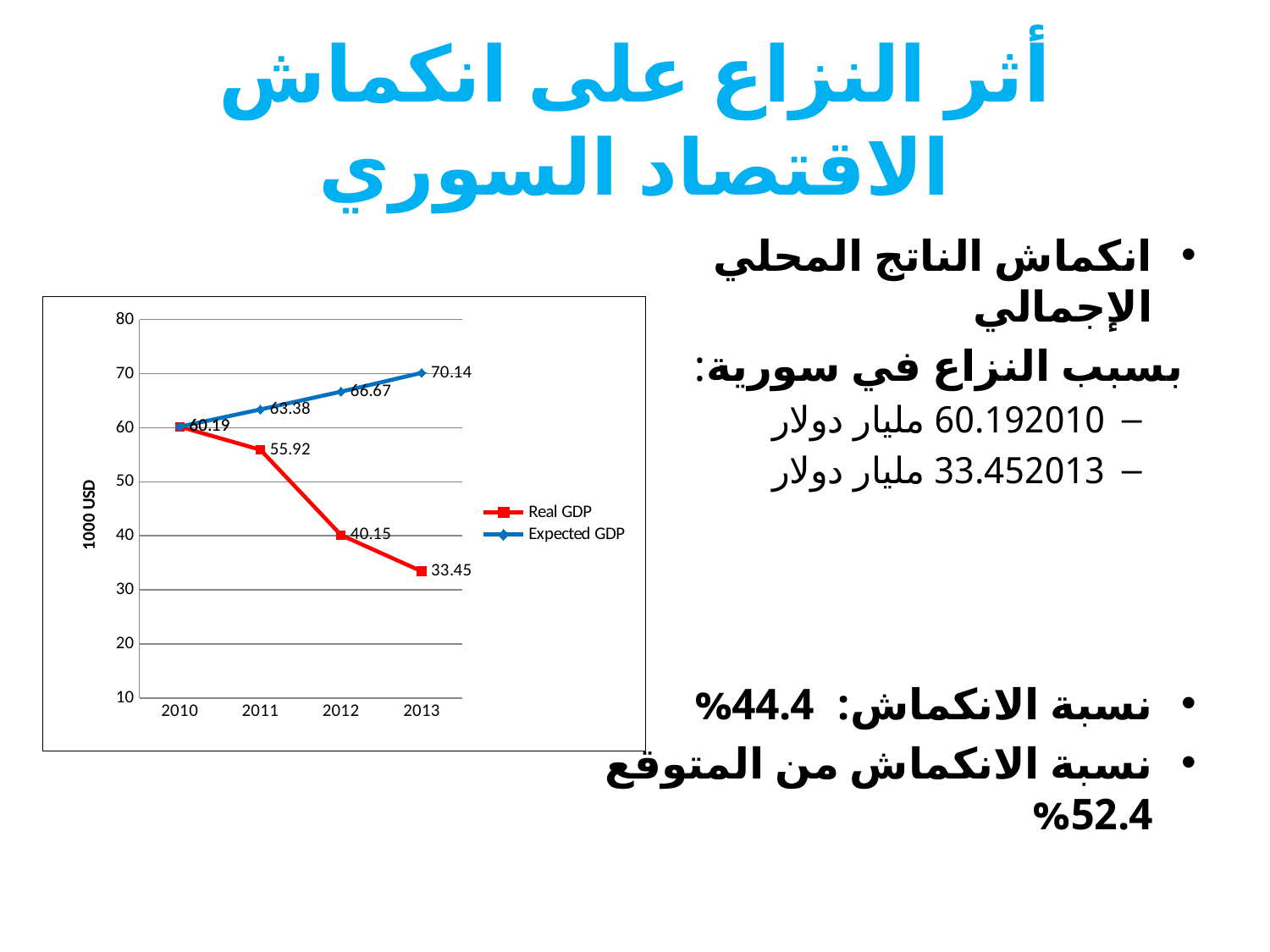
What type of chart is shown on the slide? line chart How many years are plotted on the x axis? 4 In which year is Expected GDP highest? 2013 What is the difference between Expected GDP and Real GDP in 2013? 36.69 Does Real GDP rise or fall from 2010 to 2013? fall Which is larger in 2012, Real GDP or Expected GDP? Expected GDP What is the label on the vertical axis of the chart? 1000 USD What is the Real GDP value for 2011? 55.92 What is the Expected GDP value for 2012? 66.67 In which year is Real GDP lowest? 2013 What is the Real GDP value for 2013? 33.45 How many series does the chart legend list? 2